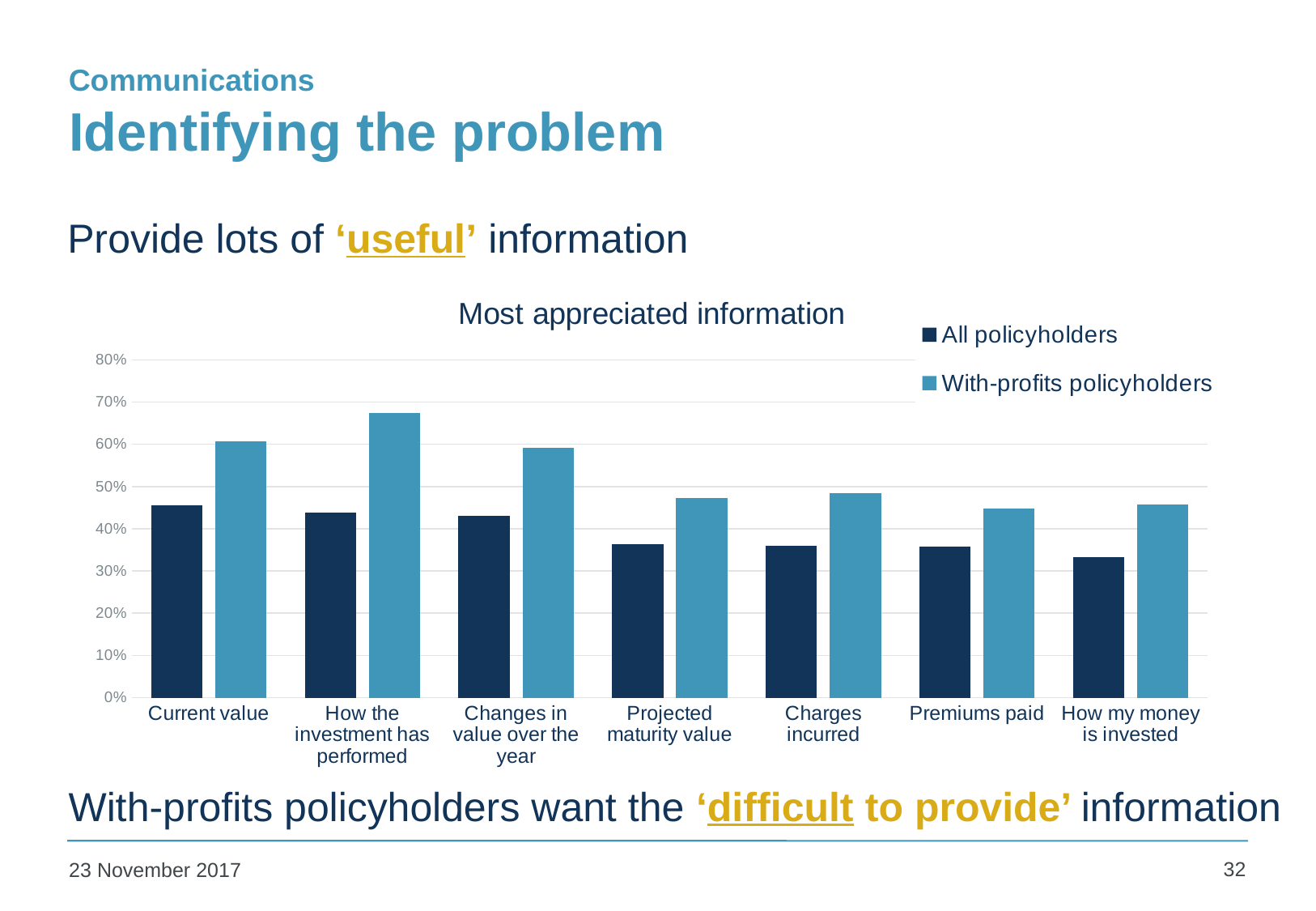
For All policyholders, which is larger: the value for Current value or the value for How my money is invested? Current value Is the All policyholders value for Projected maturity value greater or less than 40%? less How many categories are shown along the x axis of the chart? 7 Which category has the lowest value for All policyholders? How my money is invested Is the With-profits policyholders value for How the investment has performed greater or less than 60%? greater What kind of chart is shown on the slide? bar chart Which series is shown in the dark navy bars? All policyholders What is the title of the chart? Most appreciated information How many series does the chart's legend list? 2 Is the With-profits policyholders value for Current value greater or less than 50%? greater Which category has the highest value for With-profits policyholders? How the investment has performed For Current value, which series has the larger value: All policyholders or With-profits policyholders? With-profits policyholders